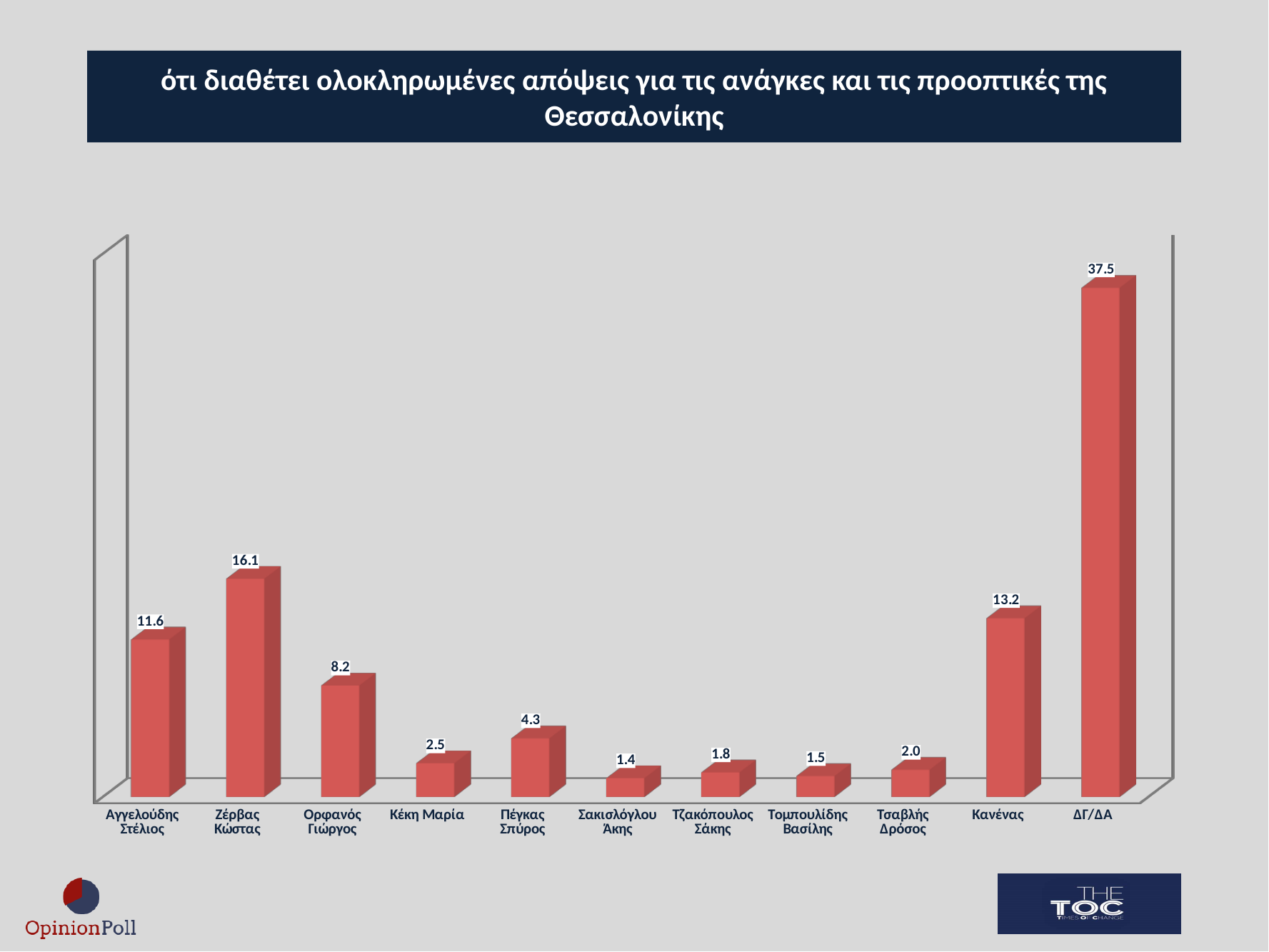
Which category has the highest value? ΔΓ/ΔΑ What value is shown for Κανένας? 13.2 What value is shown for Ορφανός Γιώργος? 8.2 What value is shown for Ζέρβας Κώστας? 16.1 Which category has the lowest value? Σακισλόγλου Άκης What value is shown for Πέγκας Σπύρος? 4.3 What colour are the bars in the chart? Red How many categories are shown on the x axis? 11 What value is shown for ΔΓ/ΔΑ? 37.5 What kind of chart is shown on the slide? Bar chart What is the difference between the values for Ζέρβας Κώστας and Αγγελούδης Στέλιος? 4.5 Which is larger, the value for Κανένας or the value for Ζέρβας Κώστας? Ζέρβας Κώστας